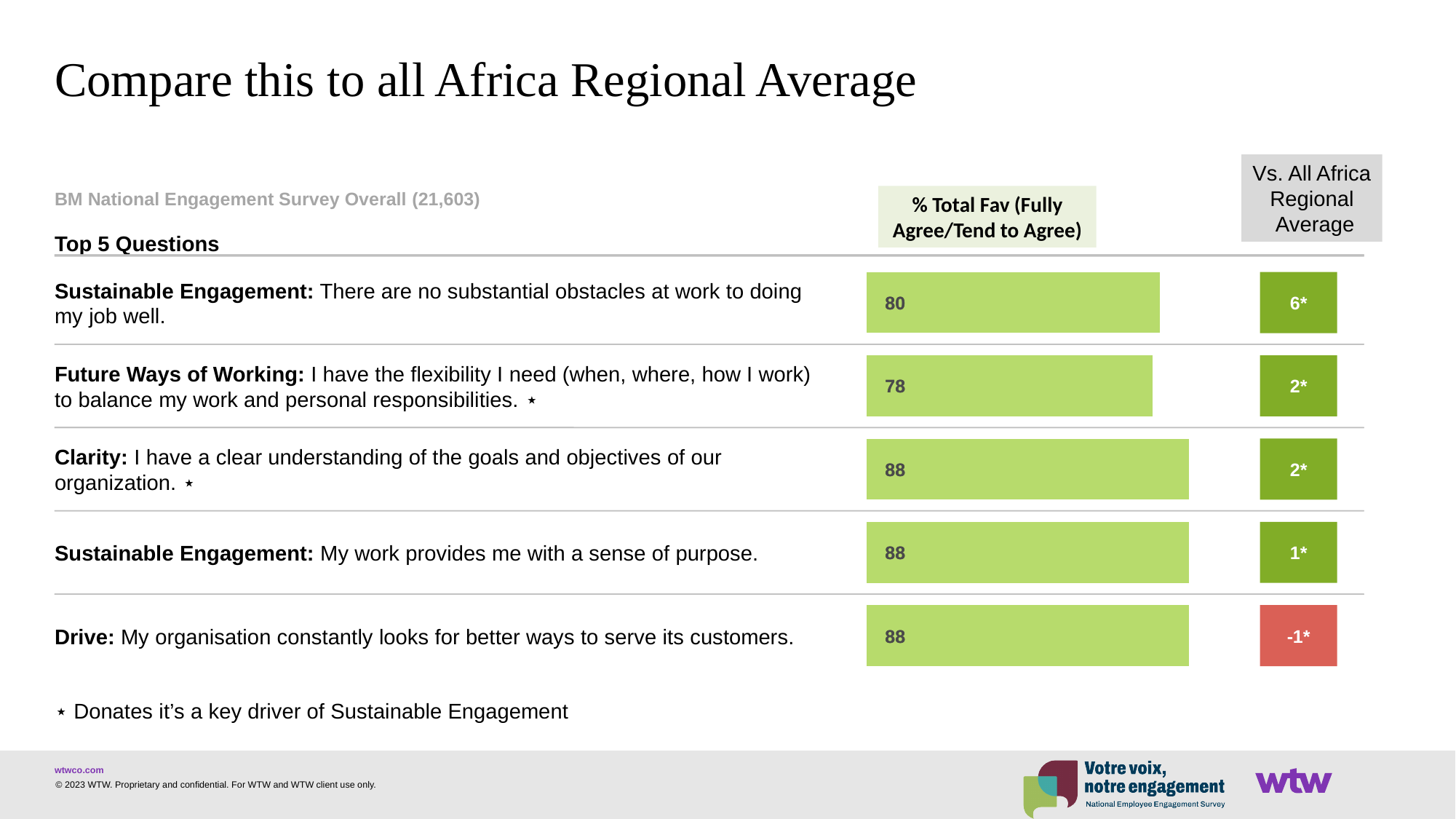
Which question has the lowest % Total Fav value? Future Ways of Working: I have the flexibility I need to balance my work and personal responsibilities What kind of chart is shown on the slide? bar chart What is the % Total Fav value for the Future Ways of Working question about flexibility? 78 How many questions (bars) are shown in the chart? 5 What is the % Total Fav value for the Clarity question about understanding the goals and objectives of the organization? 88 What is the difference in % Total Fav between the Clarity question and the Future Ways of Working question? 10 What is the Vs. All Africa Regional Average value shown for the Drive question? -1* What is the Vs. All Africa Regional Average value shown for the Sustainable Engagement question about no substantial obstacles at work? 6* Which has a higher % Total Fav: the Drive question about serving customers or the Sustainable Engagement question about no substantial obstacles? Drive: My organisation constantly looks for better ways to serve its customers What is the % Total Fav value for the Sustainable Engagement question about no substantial obstacles at work? 80 What is the title of the slide? Compare this to all Africa Regional Average What is the difference in % Total Fav between the Sustainable Engagement question about no substantial obstacles and the Future Ways of Working question? 2